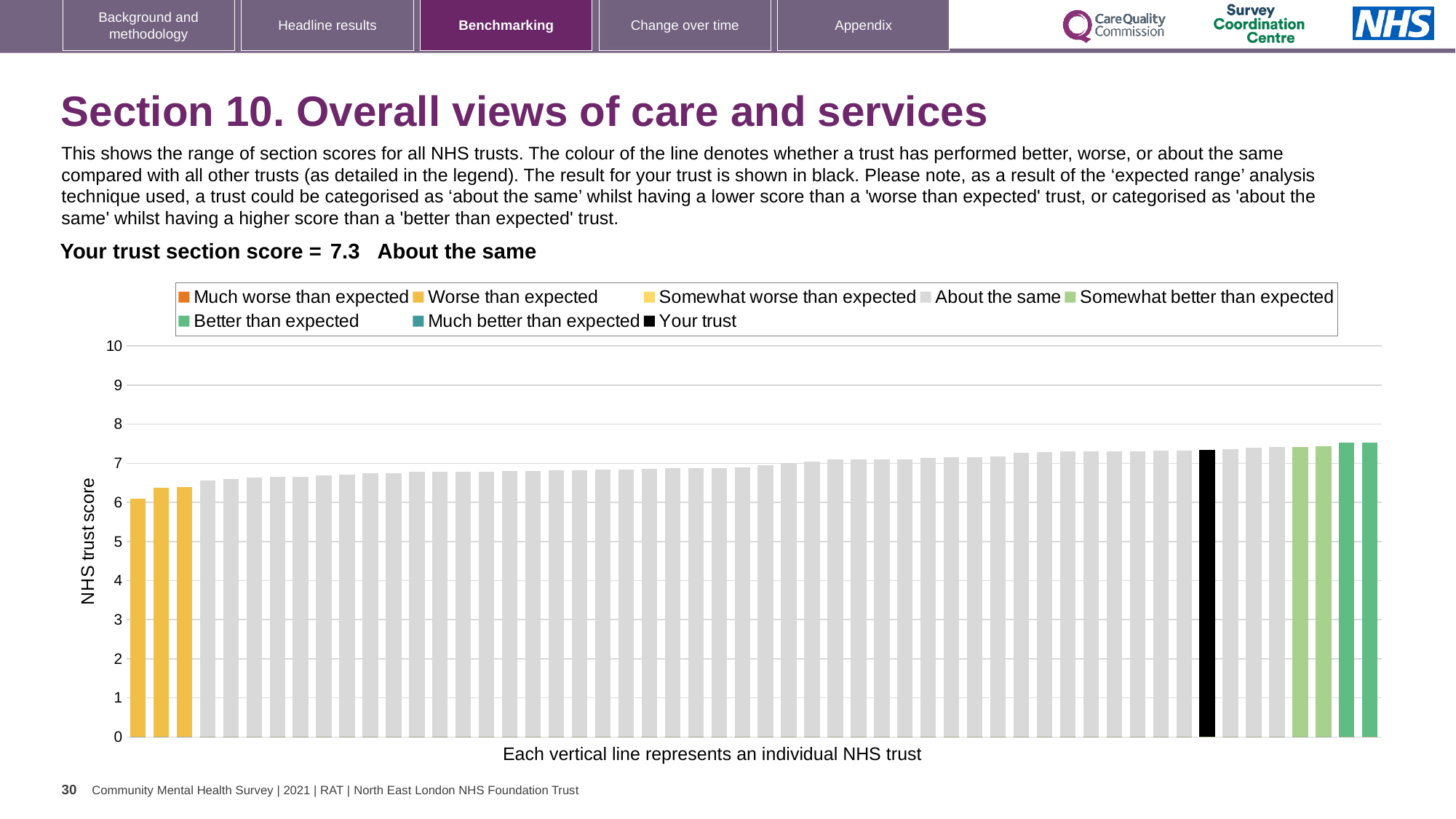
How many entries does the chart legend list? 8 Do the bar values rise or fall from left to right along the x axis? rise How many bars are coloured as 'Worse than expected' (yellow)? 3 What is the label on the vertical axis of the chart? NHS trust score Is the value for your trust (the black bar) greater or less than 7? greater Is the value of the lowest bar on the chart greater or less than 7? less Is the value of the highest bar on the chart greater or less than 7? greater How many bars are shown in black for 'Your trust'? 1 What kind of chart is shown on the slide? bar chart Which legend category does your trust's section score fall into? About the same What is the section score for your trust? 7.3